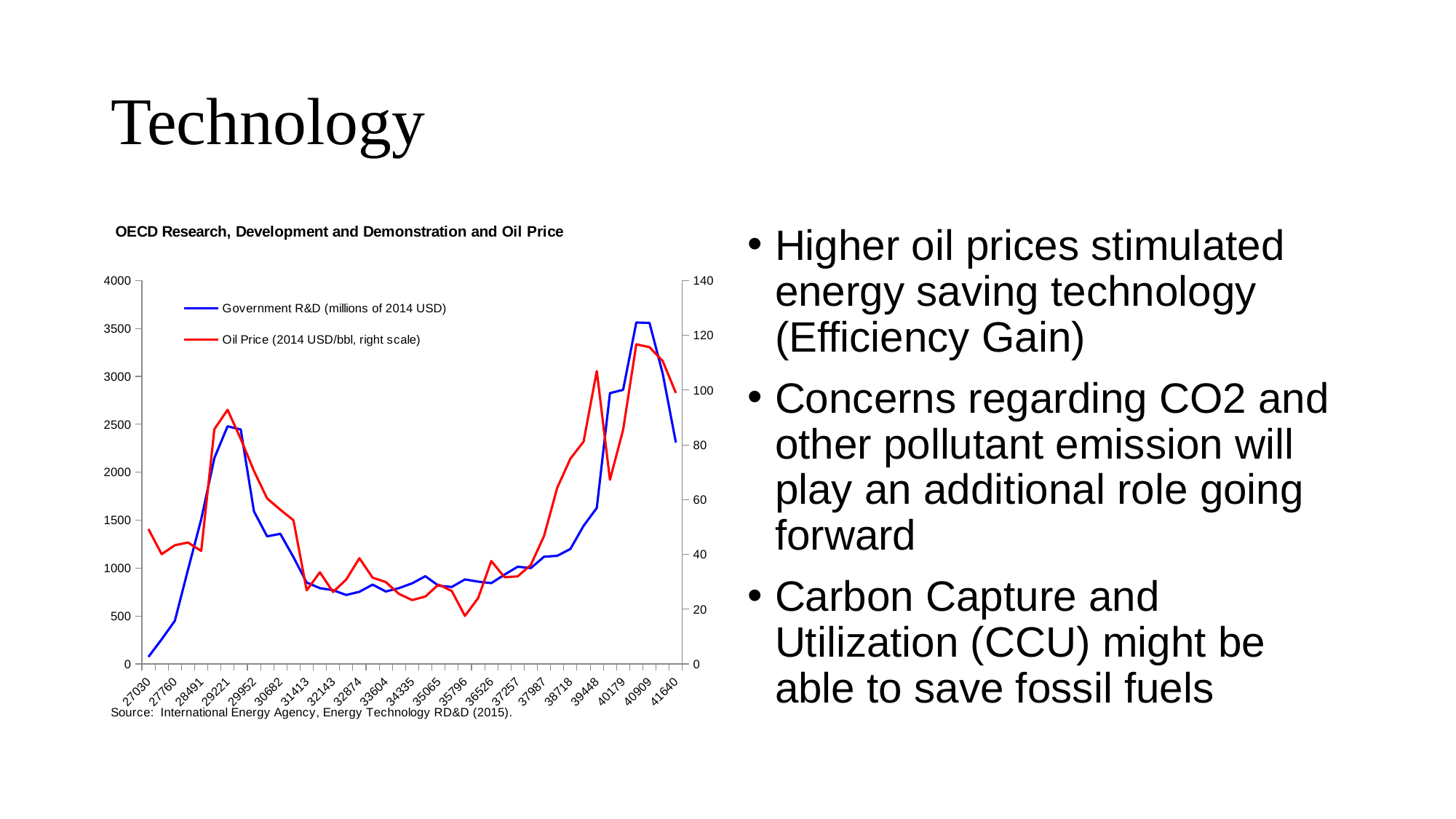
Does the Government R&D series rise or fall between 29221 and 31413? fall What kind of chart is shown on the slide? line chart Is the Government R&D value at 27030 greater or less than 500? less Is the Government R&D value at 40909 greater or less than 3000? greater At which x-axis label is the Government R&D series at its lowest? 27030 Is the Oil Price value at 39448 greater or less than 100? greater What is the title of the chart? OECD Research, Development and Demonstration and Oil Price At which x-axis label is the Oil Price series at its lowest? 35796 How many series does the chart legend list? 2 Which colour is used for the Oil Price series? red